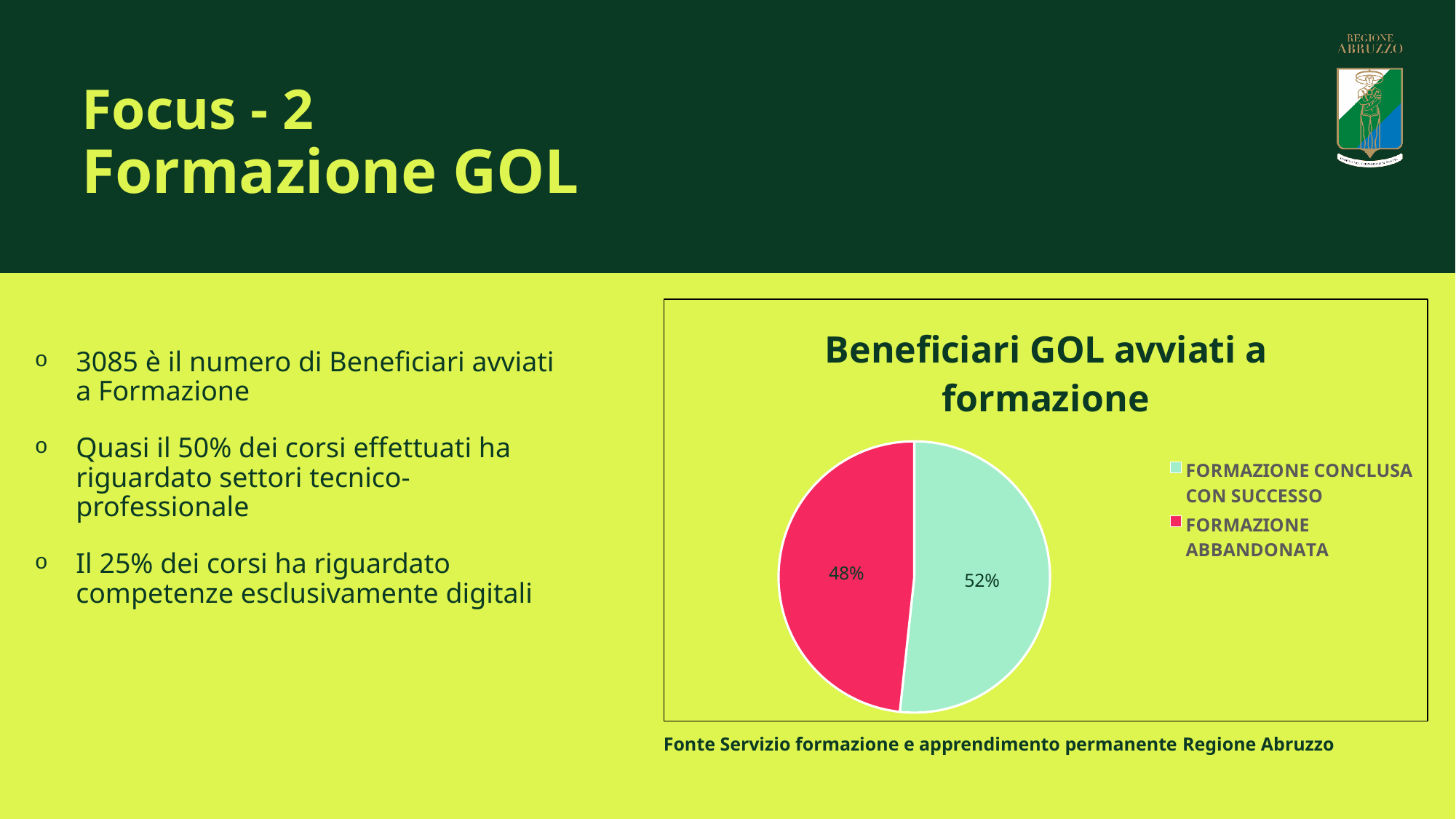
What kind of chart is shown on the slide? pie chart What colour is the FORMAZIONE ABBANDONATA slice? red/pink Which slice is the largest in the pie chart? FORMAZIONE CONCLUSA CON SUCCESSO What is the title of the chart? Beneficiari GOL avviati a formazione Is the share for FORMAZIONE ABBANDONATA greater or less than 50%? less What share of the pie is FORMAZIONE ABBANDONATA? 48% How many entries does the legend list? 2 Which is larger, FORMAZIONE CONCLUSA CON SUCCESSO or FORMAZIONE ABBANDONATA? FORMAZIONE CONCLUSA CON SUCCESSO What share of the pie is FORMAZIONE CONCLUSA CON SUCCESSO? 52% Which slice is the smallest in the pie chart? FORMAZIONE ABBANDONATA How many slices does the pie chart have? 2 What is the difference in percentage points between FORMAZIONE CONCLUSA CON SUCCESSO and FORMAZIONE ABBANDONATA? 4 percentage points